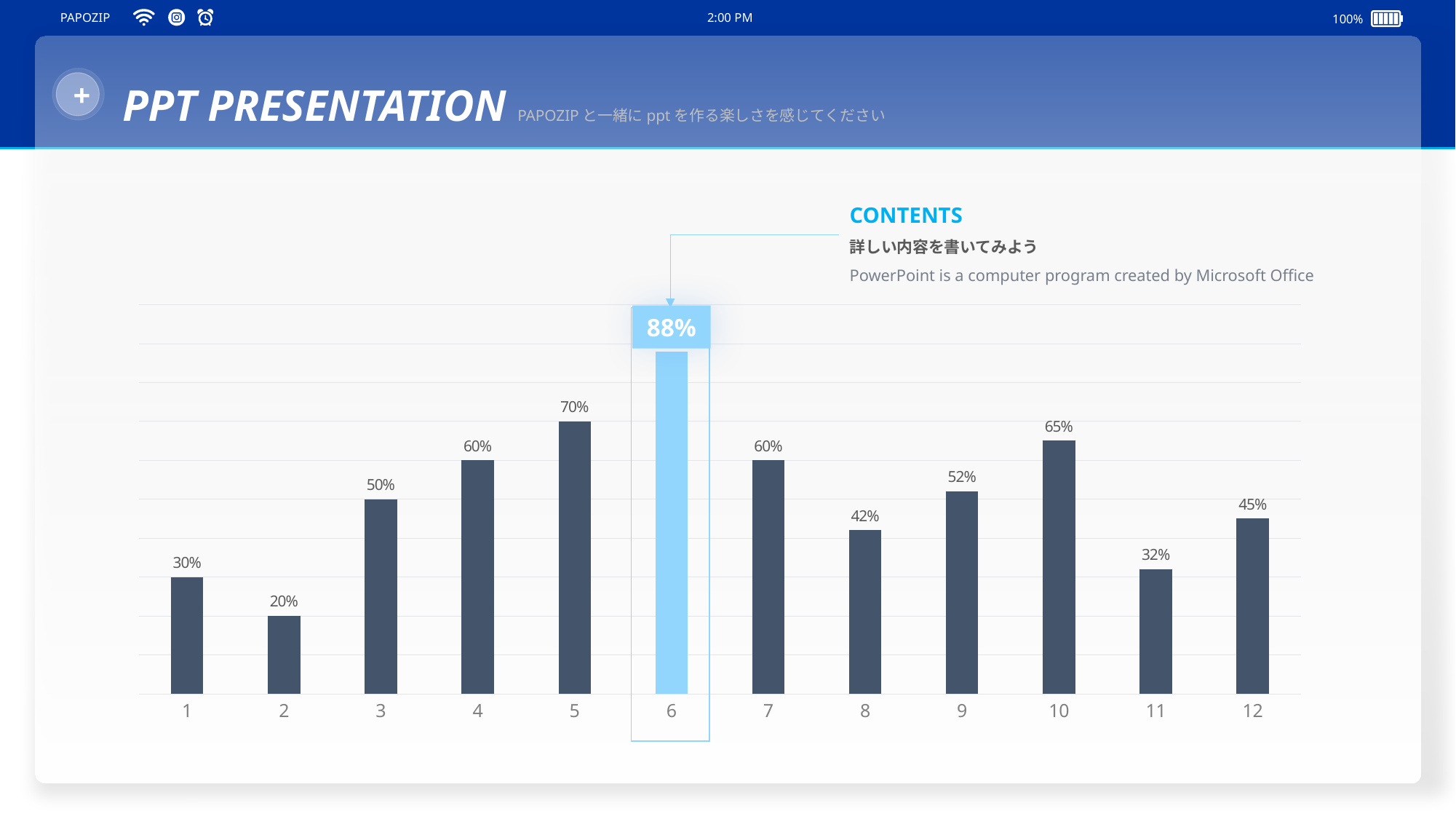
What is the difference between the values for category 6 and category 5? 18% What kind of chart is shown on the slide? bar chart How many categories are shown on the x axis? 12 What is the value for category 11? 32% What is the difference between the values for category 10 and category 8? 23% Which category has the lowest value? 2 Which is larger, the value for category 3 or the value for category 12? 3 Do the values rise or fall from category 1 to category 6? rise Which category has the highest value? 6 What is the value for category 9? 52% Which bar is highlighted in a lighter blue colour? 6 What is the value for category 6? 88%